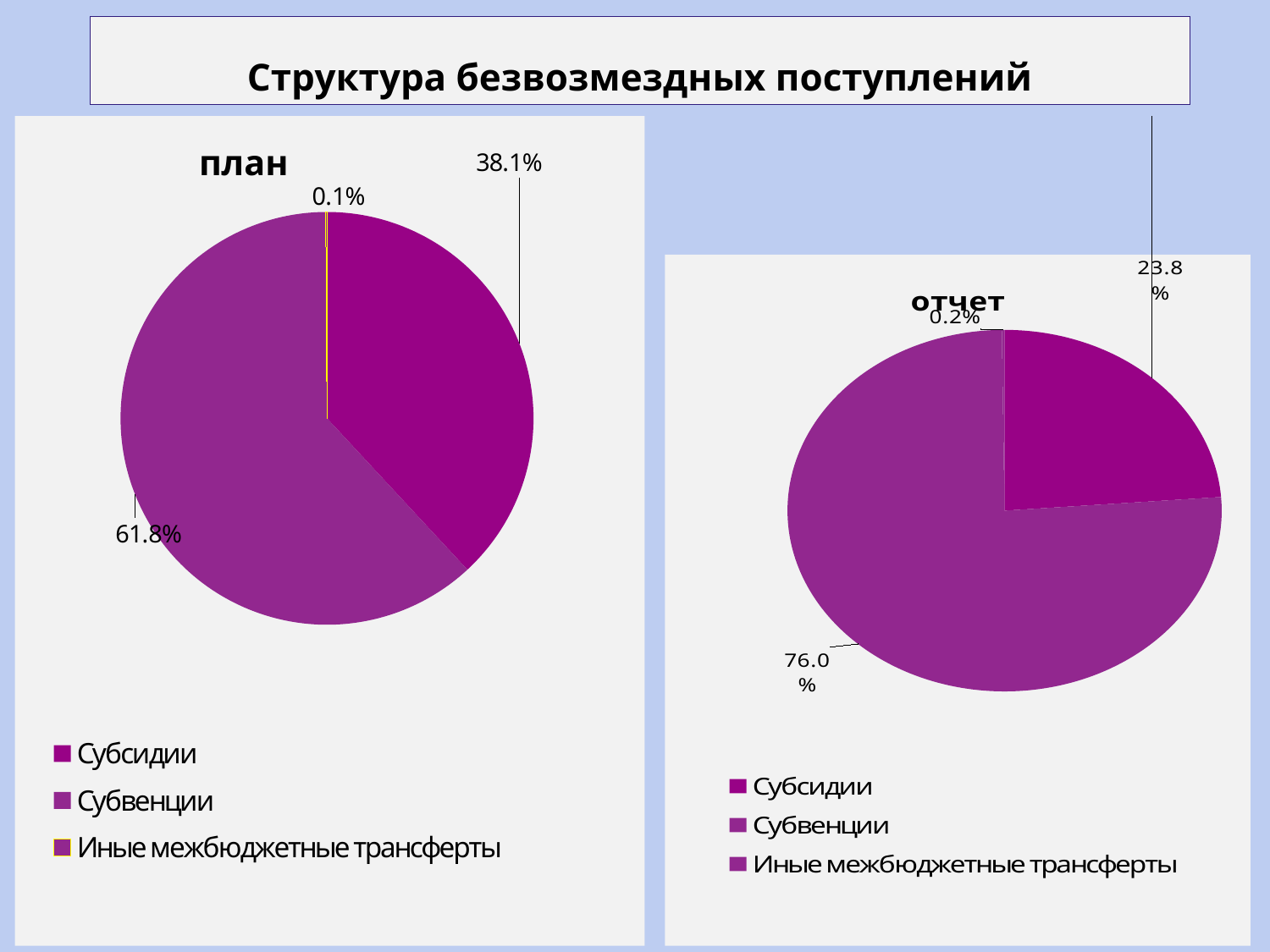
What type of chart is the "план" chart on the left? pie chart In the "отчет" pie chart, what is the share of Иные межбюджетные трансферты? 0.2% In the "план" pie chart, what is the share of Субсидии? 38.1% In the "план" pie chart, what share is labelled for the largest slice? 61.8% What is the difference between the Субвенции share in the "отчет" chart and in the "план" chart? 14.2% Is the share of Субсидии larger in the "план" chart or the "отчет" chart? план In the "отчет" pie chart, what is the share of Субсидии? 23.8% In the "план" pie chart, which category has the largest share? Субвенции In the "план" pie chart, what is the share of Иные межбюджетные трансферты? 0.1% In the "отчет" pie chart, what is the share of Субвенции? 76.0% How many categories does the legend of the "план" chart list? 3 In the "отчет" pie chart, which category has the smallest share? Иные межбюджетные трансферты